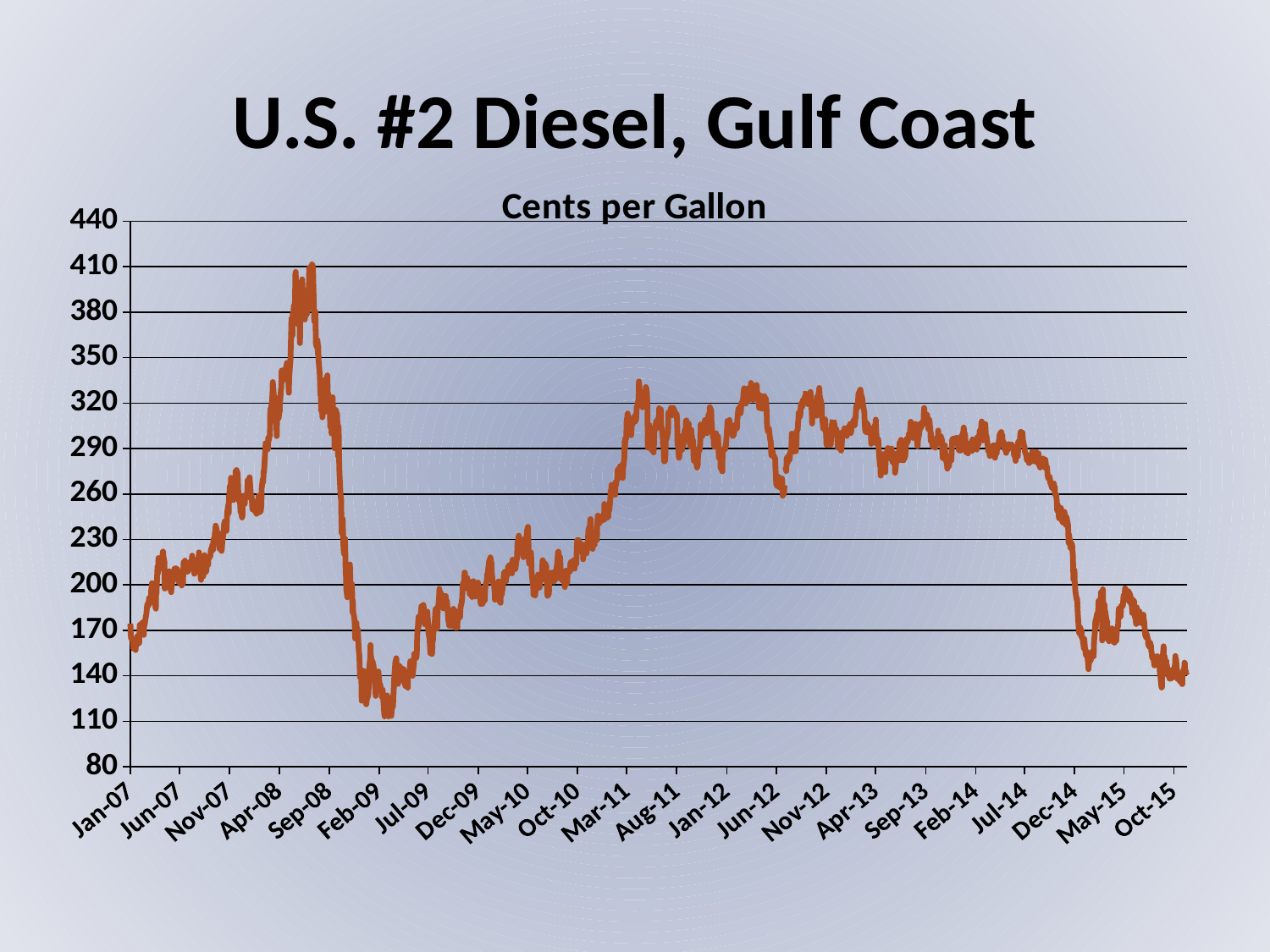
Is the value at Jul-09 greater or less than 230? less Is the value at Mar-11 greater or less than 230? greater What is the title of the chart? U.S. #2 Diesel, Gulf Coast Does the line rise or fall between Jul-14 and Oct-15? fall Is the highest point on the line greater or less than 380? greater How many date labels are shown along the x axis? 22 Does the line rise or fall between Jan-07 and Apr-08? rise What unit is the diesel price plotted in, according to the chart subtitle? Cents per Gallon What kind of chart is shown on the slide? Line chart